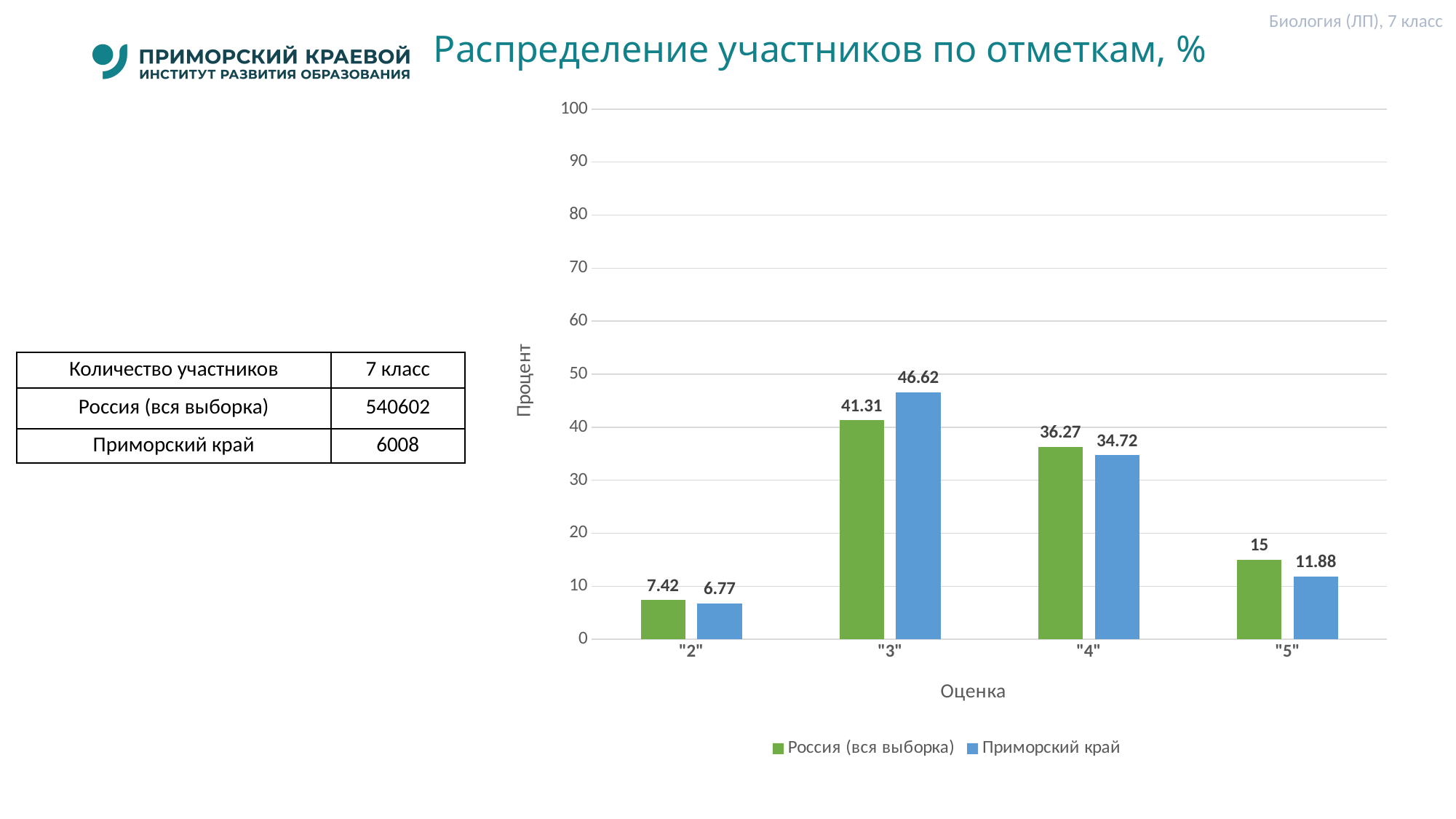
What is the difference between Приморский край and Россия (вся выборка) at grade "3"? 5.31 What is the value for Россия (вся выборка) at grade "4"? 36.27 Which grade has the lowest value for Россия (вся выборка)? "2" How many series does the legend list? 2 Which is larger at grade "5": Россия (вся выборка) or Приморский край? Россия (вся выборка) How many grade categories are shown on the x axis? 4 What is the value for Приморский край at grade "3"? 46.62 What is the value for Приморский край at grade "2"? 6.77 What is the value for Россия (вся выборка) at grade "5"? 15 What type of chart is shown on the slide? bar chart Is the value for Приморский край at grade "4" greater or less than 30? greater Which grade has the highest value for Приморский край? "3"